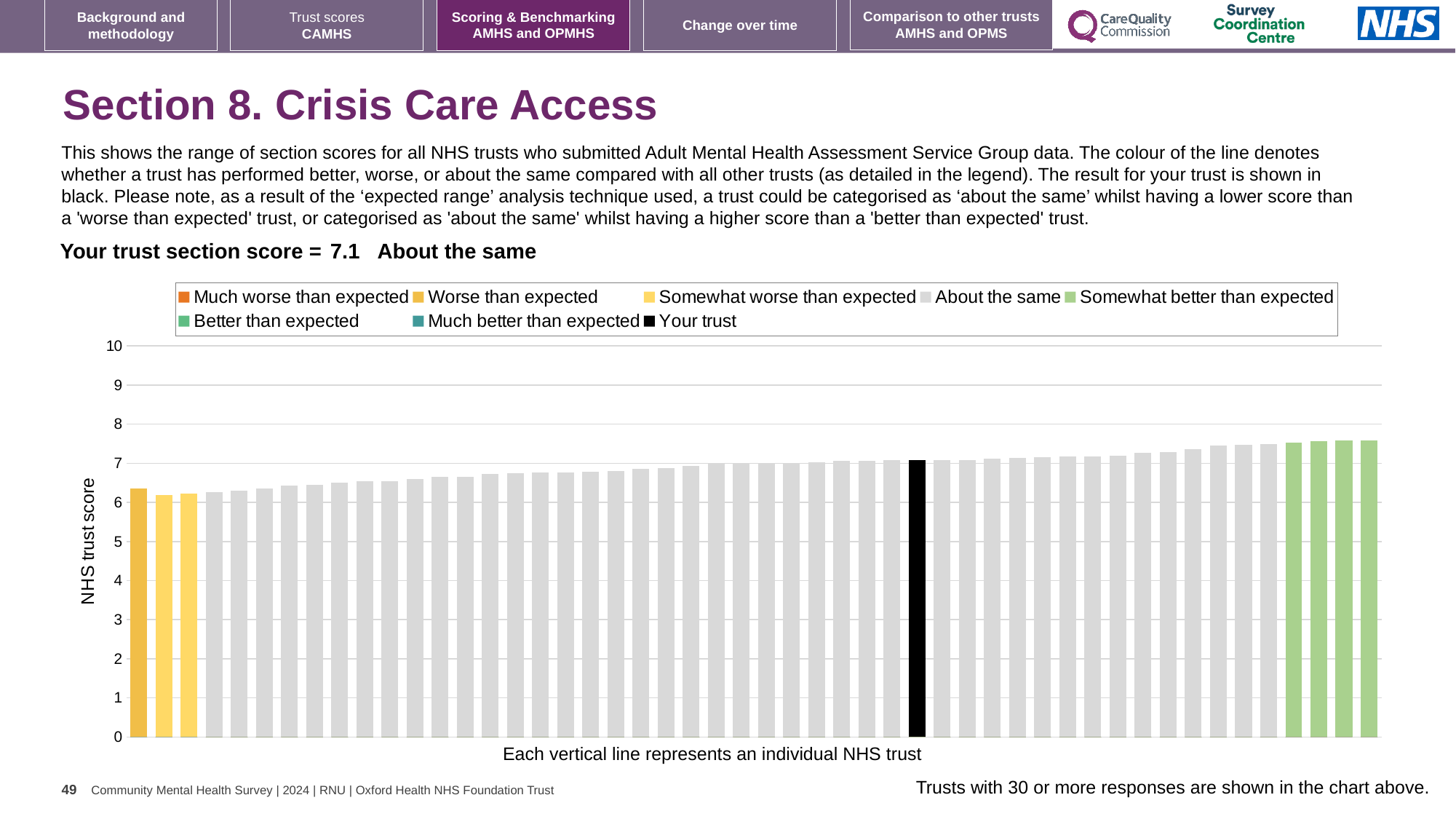
What is the section score for your trust, as printed on the slide? 7.1 Do the bar values rise or fall from left to right along the x axis? Rise How many entries does the chart legend list? 8 How many bars are coloured green (Somewhat better than expected)? 4 What is the label on the vertical axis of the chart? NHS trust score Which category is your trust placed in for this section? About the same Is the value for the black 'Your trust' bar greater or less than 8? less What kind of chart is shown on the slide? Bar chart Are the values for the green bars at the right of the chart greater or less than 8? less How many bars are coloured yellow (Worse than expected)? 1 Is the value for the leftmost (orange) bar greater or less than 7? less